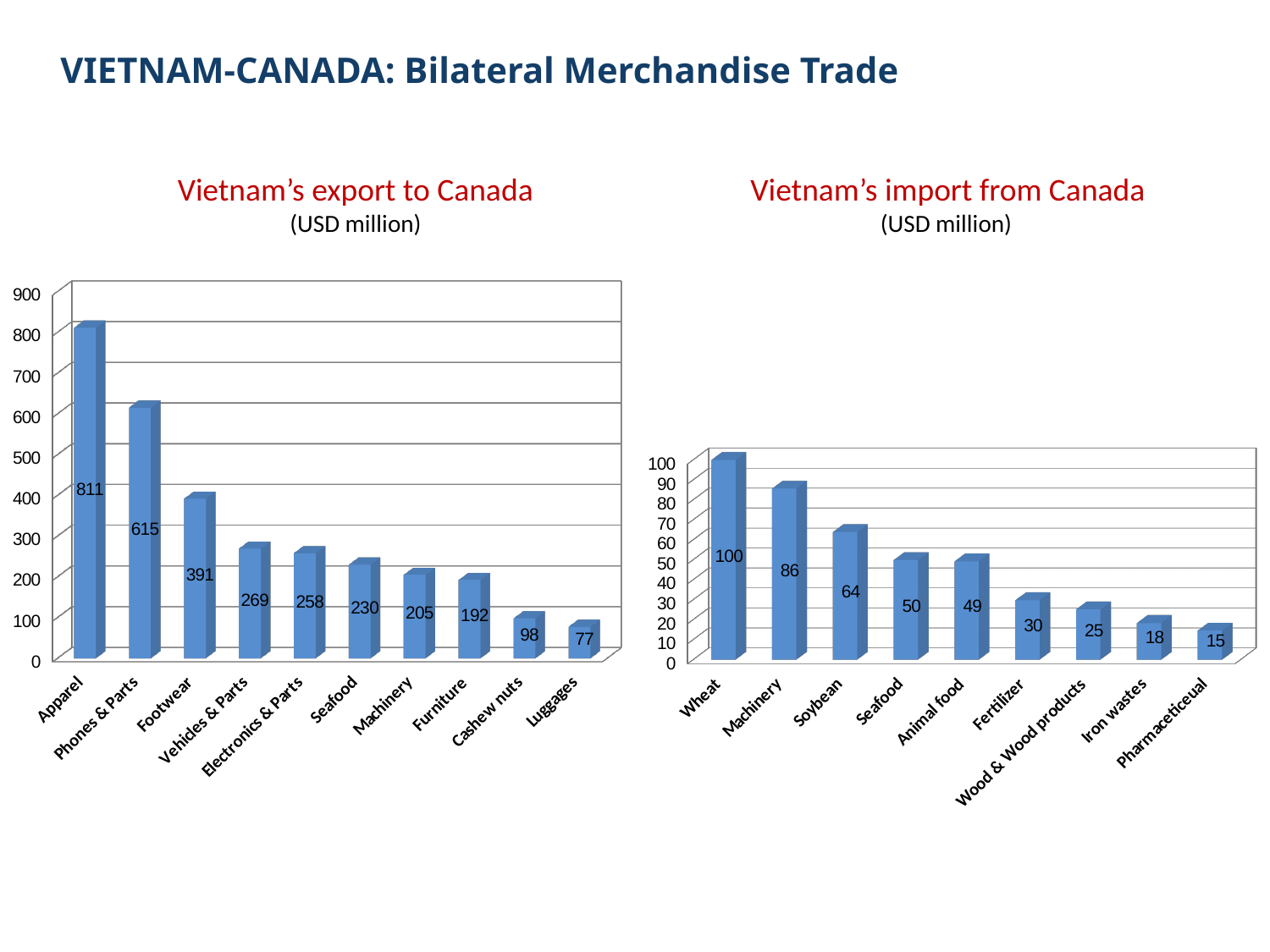
In the 'Vietnam's import from Canada' chart, what is the value for Soybean? 64 In the 'Vietnam's export to Canada' chart, how many categories are shown? 10 In the 'Vietnam's export to Canada' chart, what is the difference between Apparel and Phones & Parts? 196 What kind of chart is the 'Vietnam's import from Canada' chart? bar chart In the 'Vietnam's import from Canada' chart, how many categories are shown? 9 In the 'Vietnam's export to Canada' chart, what is the value for Footwear? 391 In the 'Vietnam's import from Canada' chart, which category has the highest value? Wheat In the 'Vietnam's export to Canada' chart, which category has the lowest value? Luggages In the 'Vietnam's export to Canada' chart, do the values rise or fall from left to right? fall In the 'Vietnam's import from Canada' chart, what is the difference between Machinery and Seafood? 36 In the 'Vietnam's import from Canada' chart, which is larger, Fertilizer or Wood & Wood products? Fertilizer In the 'Vietnam's export to Canada' chart, which category has the highest value? Apparel